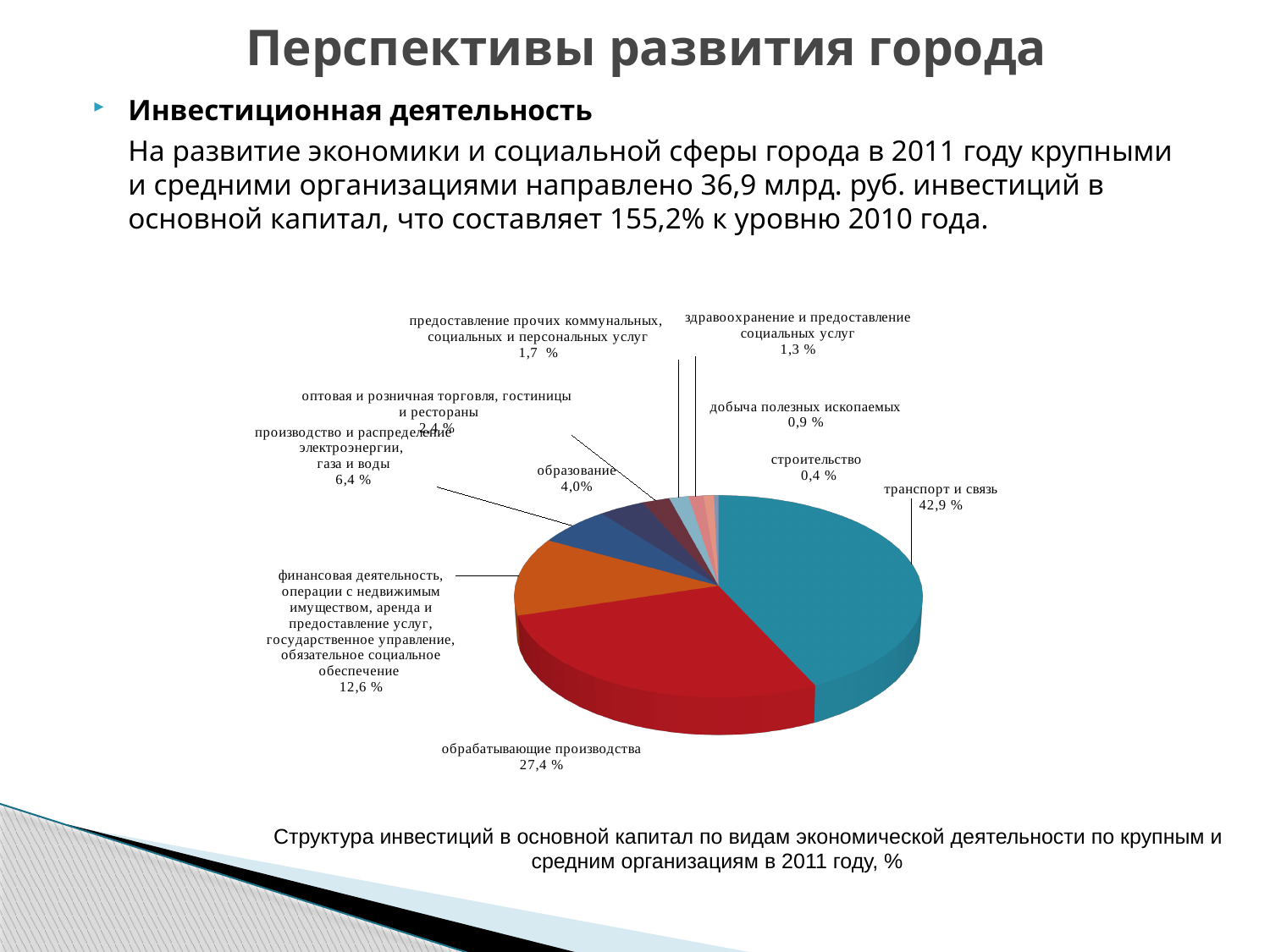
How many types of economic activity are shown in the pie chart? 10 What share of investments goes to транспорт и связь? 42,9 % Which type of economic activity has the smallest share of investments? строительство Which type of economic activity has the largest share of investments? транспорт и связь What is the difference in percentage points between транспорт и связь and обрабатывающие производства? 15,5 What share of investments goes to обрабатывающие производства? 27,4 % What kind of chart is shown on the slide? pie chart What year does the chart caption say the investment structure refers to? 2011 What share of investments goes to производство и распределение электроэнергии, газа и воды? 6,4 % Which has a larger share: здравоохранение и предоставление социальных услуг or предоставление прочих коммунальных, социальных и персональных услуг? предоставление прочих коммунальных, социальных и персональных услуг What share of investments goes to добыча полезных ископаемых? 0,9 % What share of investments goes to образование? 4,0%